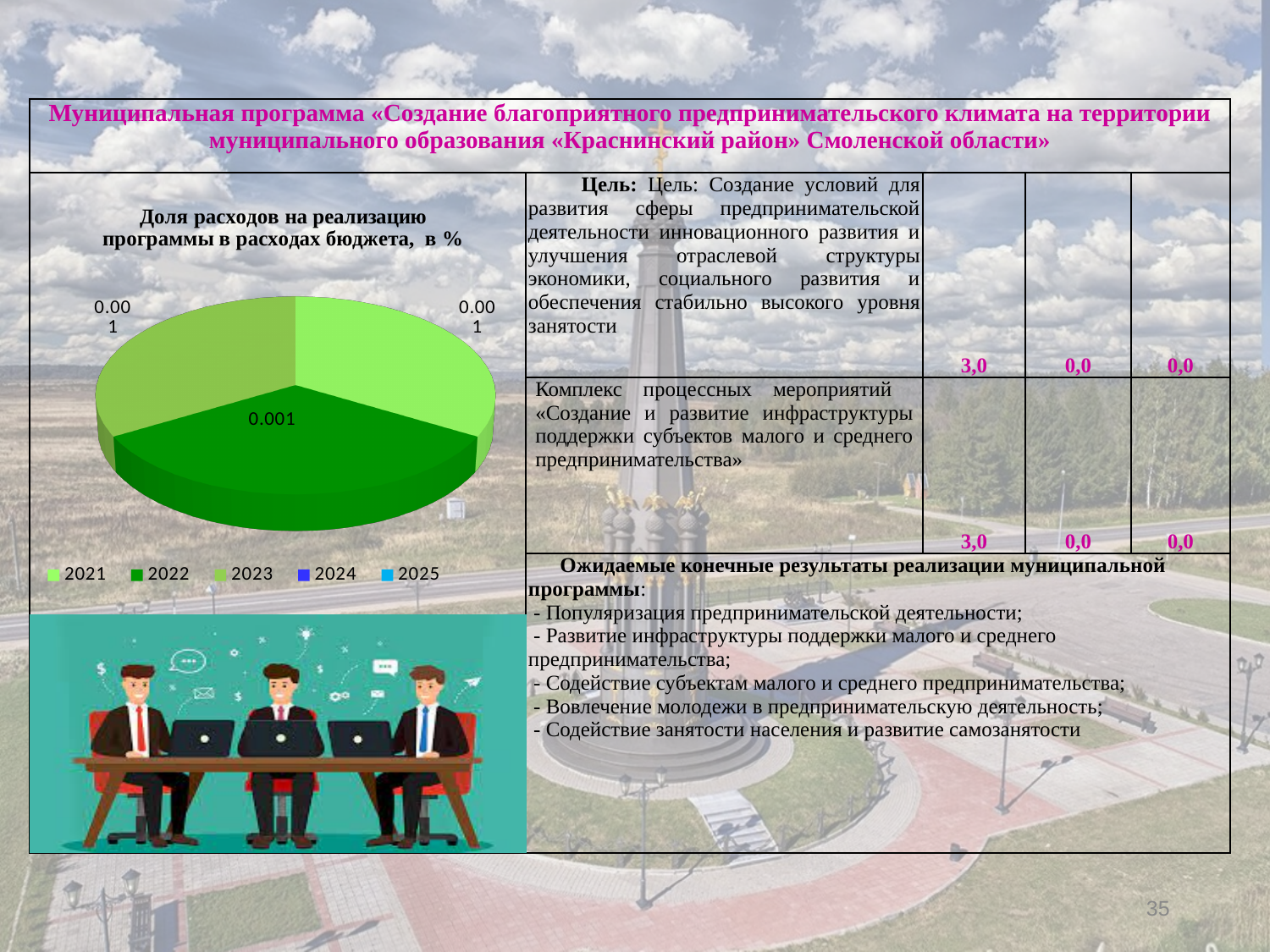
What value is printed on the dark green slice of the pie chart? 0.001 Is the value printed on the dark green slice of the pie chart greater or less than 1? less Which years are listed in the legend of the pie chart? 2021, 2022, 2023, 2024, 2025 How many slices are visible in the pie chart? 3 Are the three labelled slices of the pie chart equal in value? yes What value is printed on the top-left slice of the pie chart? 0.001 What value is printed on the top-right slice of the pie chart? 0.001 What is the title of the pie chart? Доля расходов на реализацию программы в расходах бюджета, в % How many entries does the legend of the pie chart list? 5 What kind of chart is shown on the left of the slide? pie chart